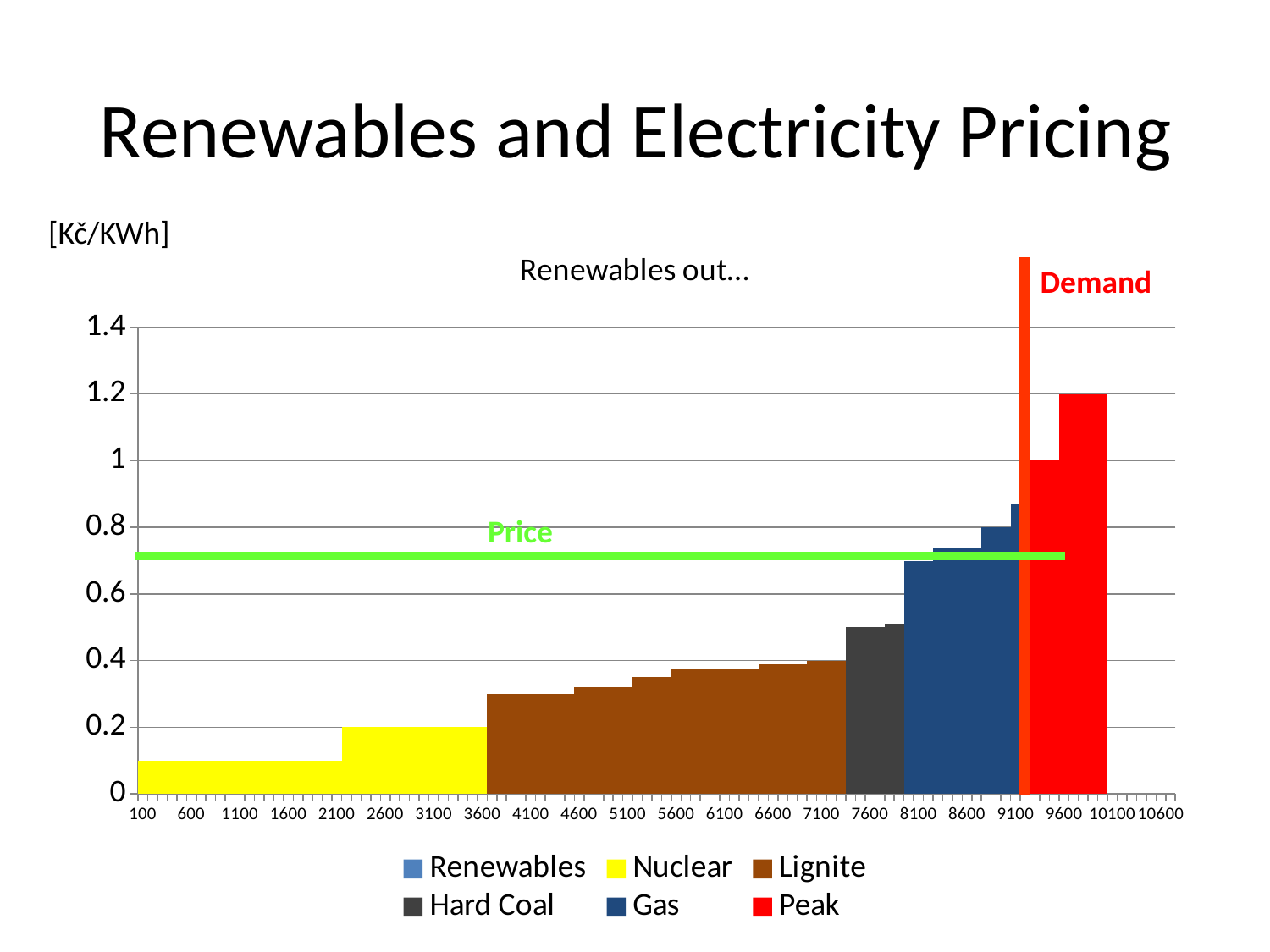
Do the bar values rise or fall from left to right along the x axis? rise How many series does the legend list? 6 Which series has larger values, Gas or Lignite? Gas What kind of chart is shown on the slide? bar chart Which series has the highest bars in the chart? Peak Are the Gas bars greater or less than 0.6? greater Are the Nuclear bars greater or less than 0.4? less Are the Hard Coal bars greater or less than 0.6? less What is the value of the tallest Peak bar? 1.2 What is the title of the chart? Renewables out… What label is written on the green horizontal line across the chart? Price Which series has the lowest bars in the chart? Nuclear